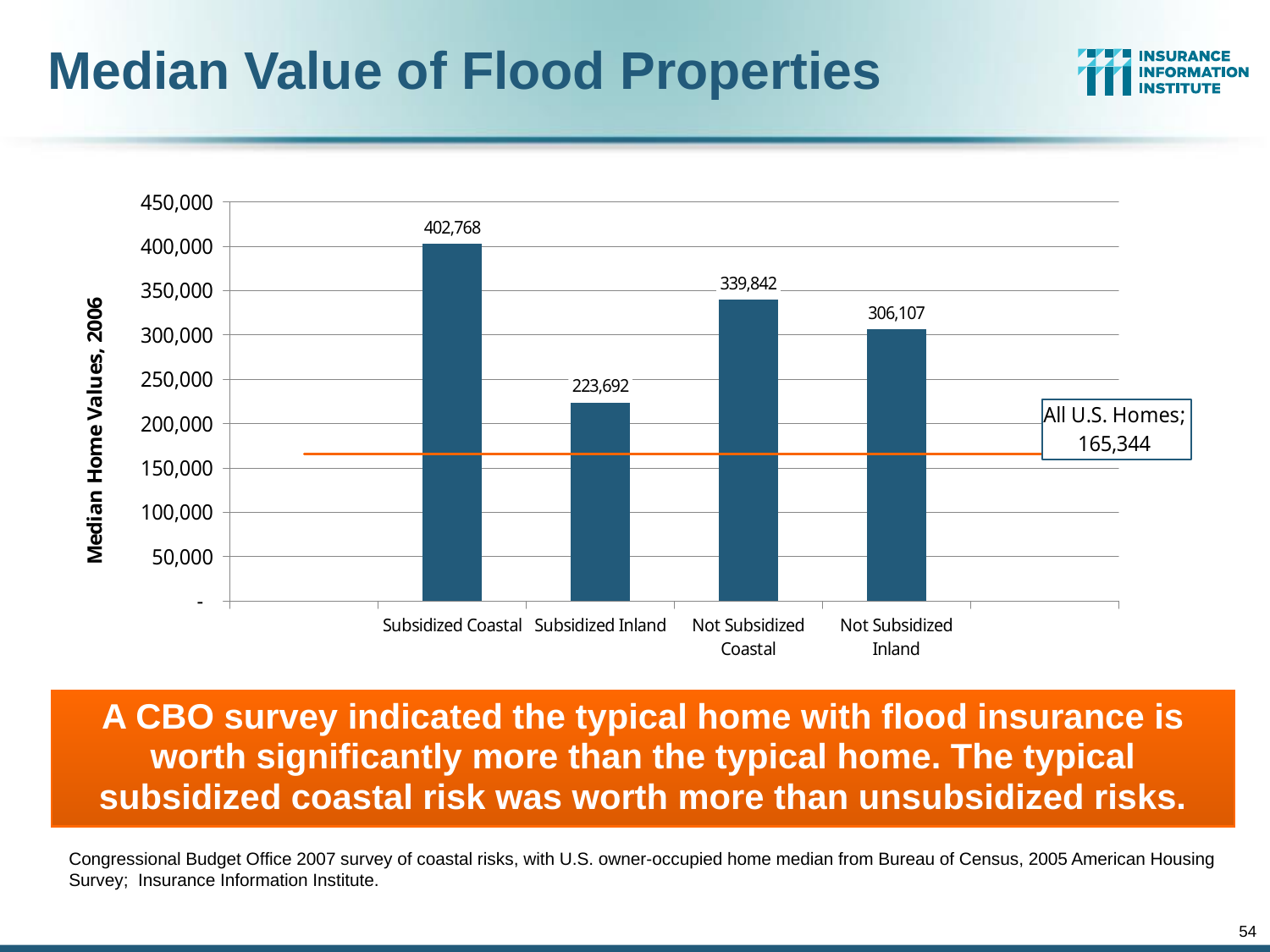
Which category has the highest median home value? Subsidized Coastal What value does the horizontal line labeled 'All U.S. Homes' represent? 165,344 Which is larger, the median home value for Not Subsidized Coastal or Not Subsidized Inland? Not Subsidized Coastal What is the median home value for Not Subsidized Coastal properties? 339,842 What is the difference between the median home values for Not Subsidized Coastal and Not Subsidized Inland properties? 33,735 What is the median home value for Subsidized Inland properties? 223,692 What is the median home value for Subsidized Coastal properties? 402,768 How many bars are shown in the chart? 4 What is the median home value for Not Subsidized Inland properties? 306,107 Which category has the lowest median home value? Subsidized Inland What is the difference between the median home values for Subsidized Coastal and Subsidized Inland properties? 179,076 What type of chart is shown on the slide? Bar chart